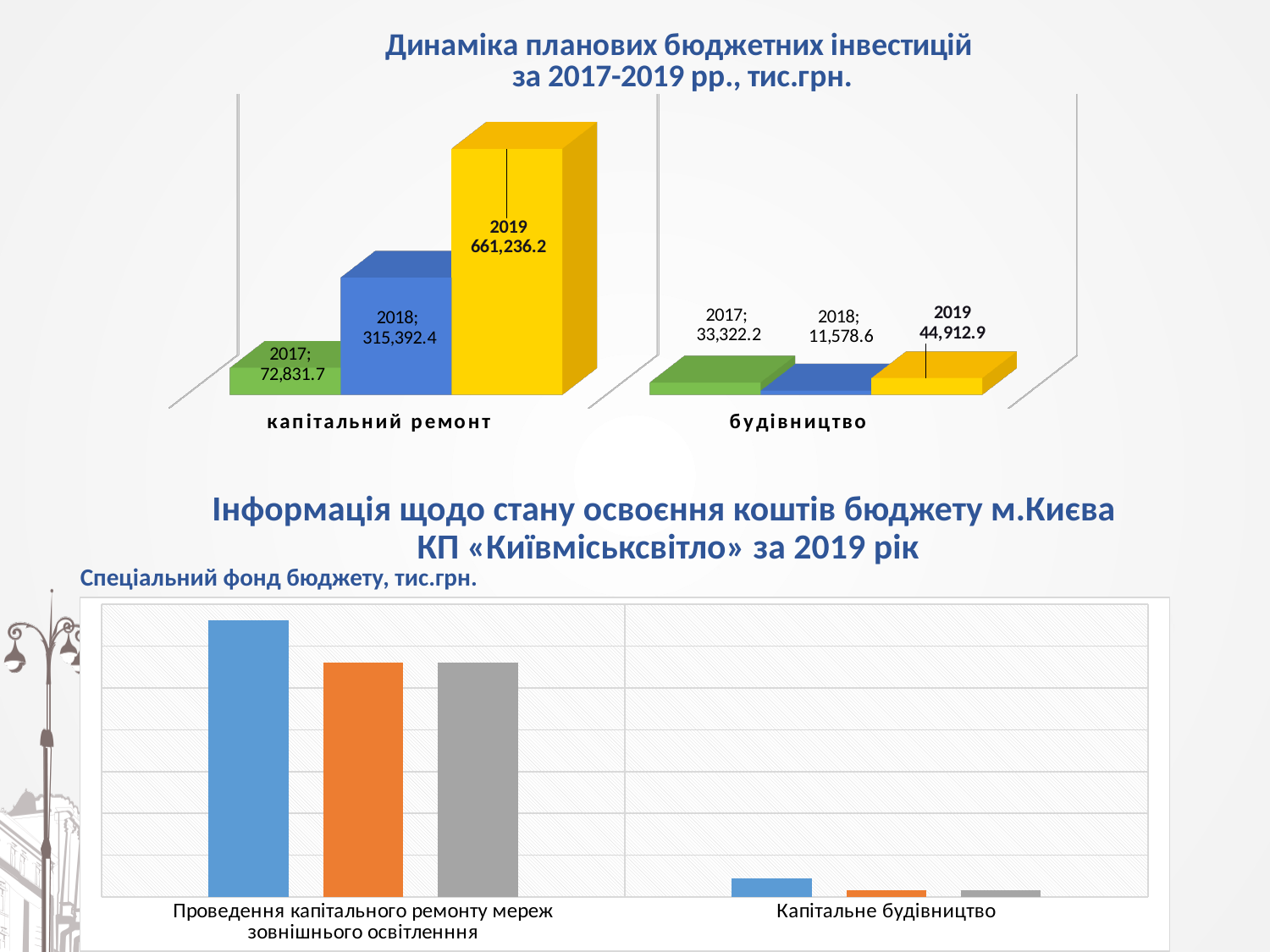
In the top chart 'Динаміка планових бюджетних інвестицій', what is the difference between the 2019 and 2017 values for будівництво? 11,590.7 In the top chart 'Динаміка планових бюджетних інвестицій', what is the difference between the 2019 and 2018 values for капітальний ремонт? 345,843.8 In the top chart 'Динаміка планових бюджетних інвестицій', what is the value for будівництво in 2018? 11,578.6 In the top chart 'Динаміка планових бюджетних інвестицій', what is the value for капітальний ремонт in 2019? 661,236.2 In the bottom chart 'Спеціальний фонд бюджету, тис.грн.', which category has the taller bars: Проведення капітального ремонту мереж зовнішнього освітлення or Капітальне будівництво? Проведення капітального ремонту мереж зовнішнього освітлення What kind of chart is the bottom chart 'Спеціальний фонд бюджету, тис.грн.'? bar chart In the top chart 'Динаміка планових бюджетних інвестицій', do the values for капітальний ремонт rise or fall from 2017 to 2019? rise In the top chart 'Динаміка планових бюджетних інвестицій', which is larger: будівництво in 2017 or будівництво in 2019? будівництво in 2019 In the top chart 'Динаміка планових бюджетних інвестицій', how many years are shown for each category? 3 In the top chart 'Динаміка планових бюджетних інвестицій', which year has the lowest value for будівництво? 2018 In the top chart 'Динаміка планових бюджетних інвестицій', which year has the highest value for капітальний ремонт? 2019 In the top chart 'Динаміка планових бюджетних інвестицій', what is the value for капітальний ремонт in 2017? 72,831.7